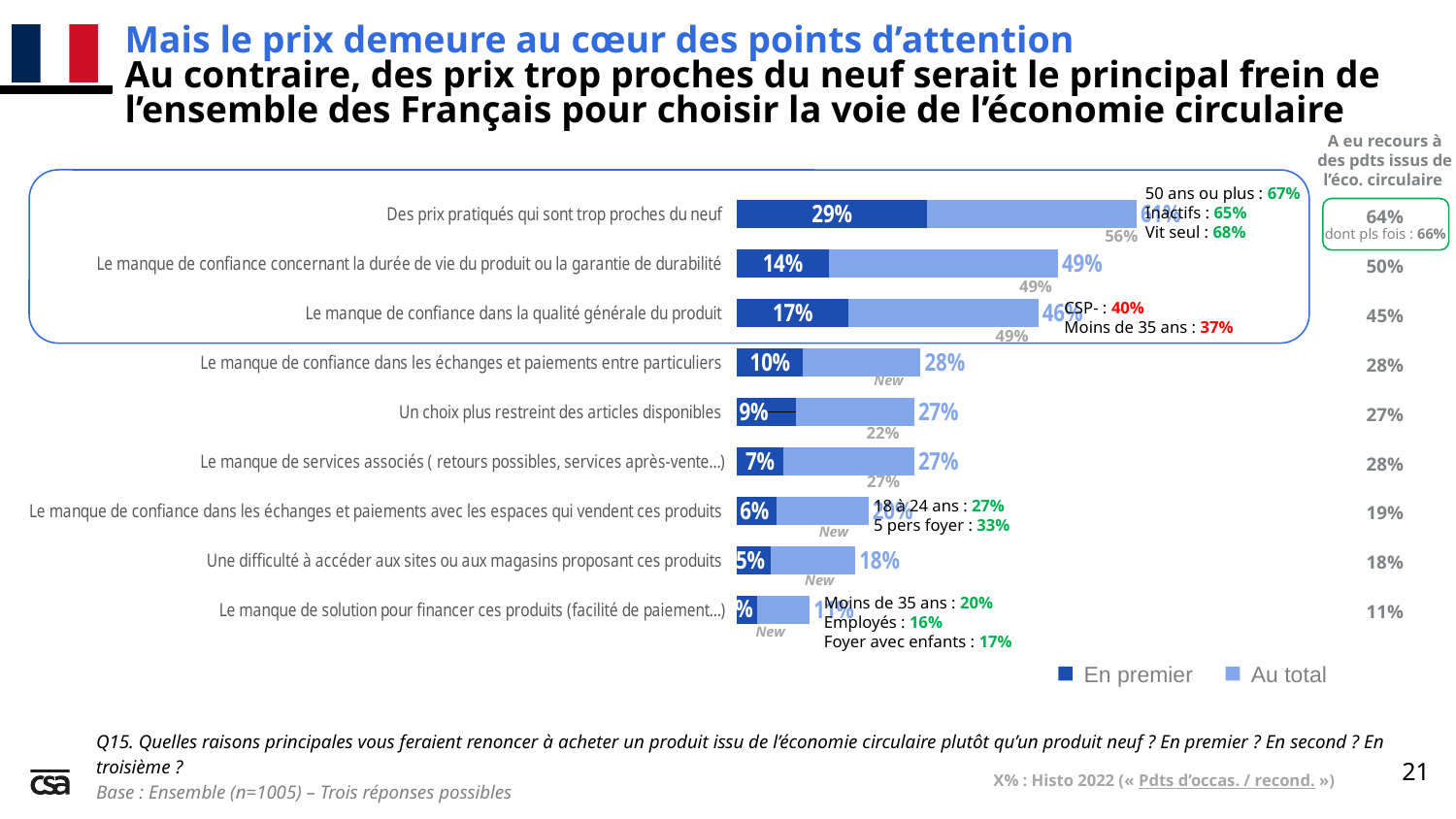
Which reason has the highest 'En premier' value? Des prix pratiqués qui sont trop proches du neuf Which reason has the lowest 'Au total' value? Le manque de solution pour financer ces produits (facilité de paiement...) What is the 'En premier' value for 'Le manque de confiance dans la qualité générale du produit'? 17% What is the 'Au total' value for 'Le manque de confiance concernant la durée de vie du produit ou la garantie de durabilité'? 49% What is the 'Au total' value for 'Le manque de confiance dans les échanges et paiements entre particuliers'? 28% What kind of chart is shown on the slide? bar chart What is the 'Au total' value for 'Une difficulté à accéder aux sites ou aux magasins proposant ces produits'? 18% How many series does the chart legend list? 2 How many reasons (categories) are plotted in the chart? 9 What is the 'En premier' value for 'Des prix pratiqués qui sont trop proches du neuf'? 29% What is the difference between the 'En premier' values for 'Des prix pratiqués qui sont trop proches du neuf' and 'Le manque de confiance concernant la durée de vie du produit ou la garantie de durabilité'? 15% What are the two series named in the legend? En premier, Au total